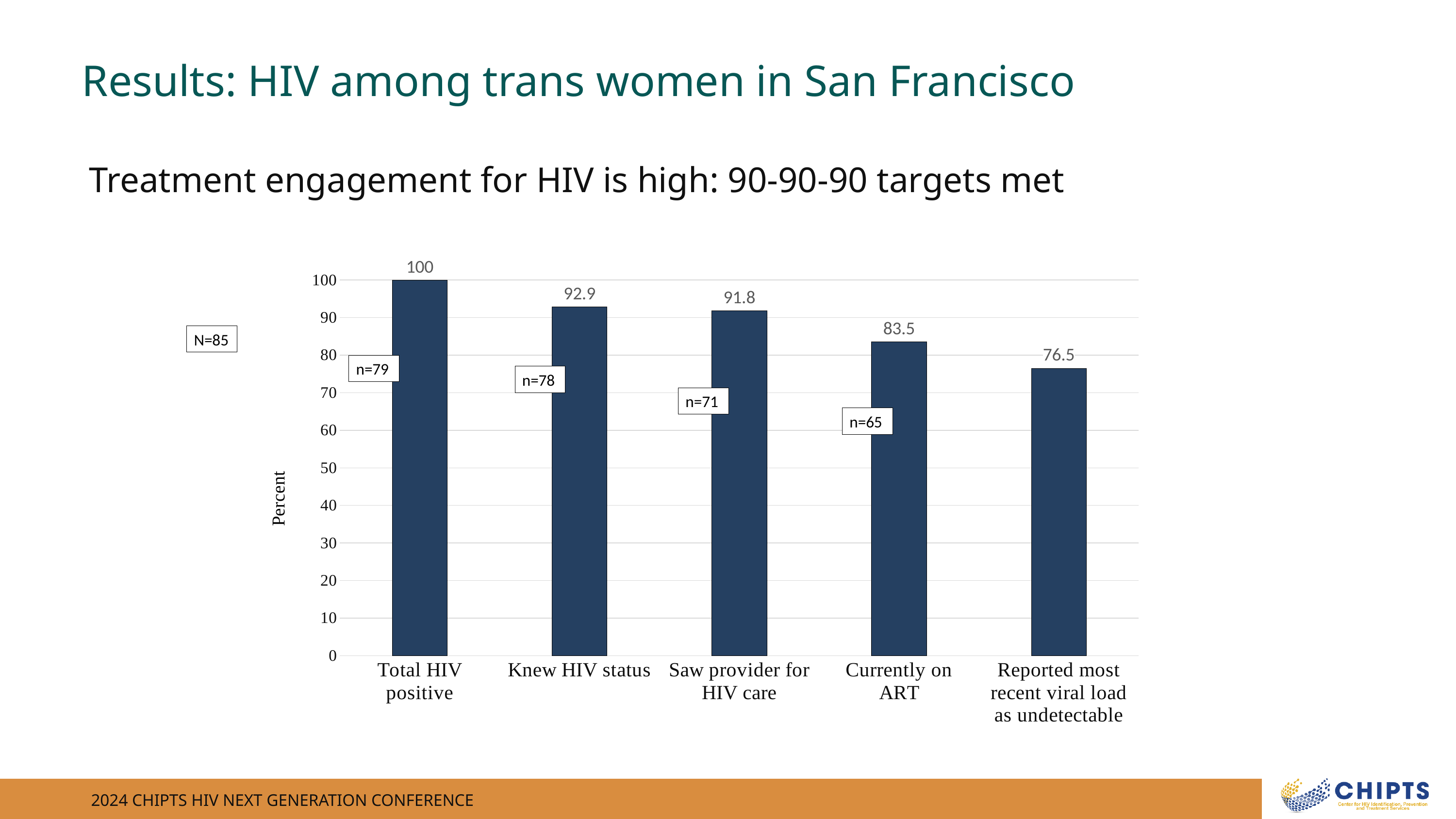
What is the value for Reported most recent viral load as undetectable? 76.5 What is the value for Currently on ART? 83.5 Which category has the lowest value? Reported most recent viral load as undetectable Is the value for Reported most recent viral load as undetectable greater or less than 80? less Do the values rise or fall from left to right along the x axis? fall What kind of chart is shown on the slide? bar chart What is the difference between the values for Total HIV positive and Currently on ART? 16.5 How many categories are shown on the x axis? 5 What is the value for Saw provider for HIV care? 91.8 Which category has the highest value? Total HIV positive What is the value for Knew HIV status? 92.9 Which is larger, the value for Knew HIV status or the value for Currently on ART? Knew HIV status